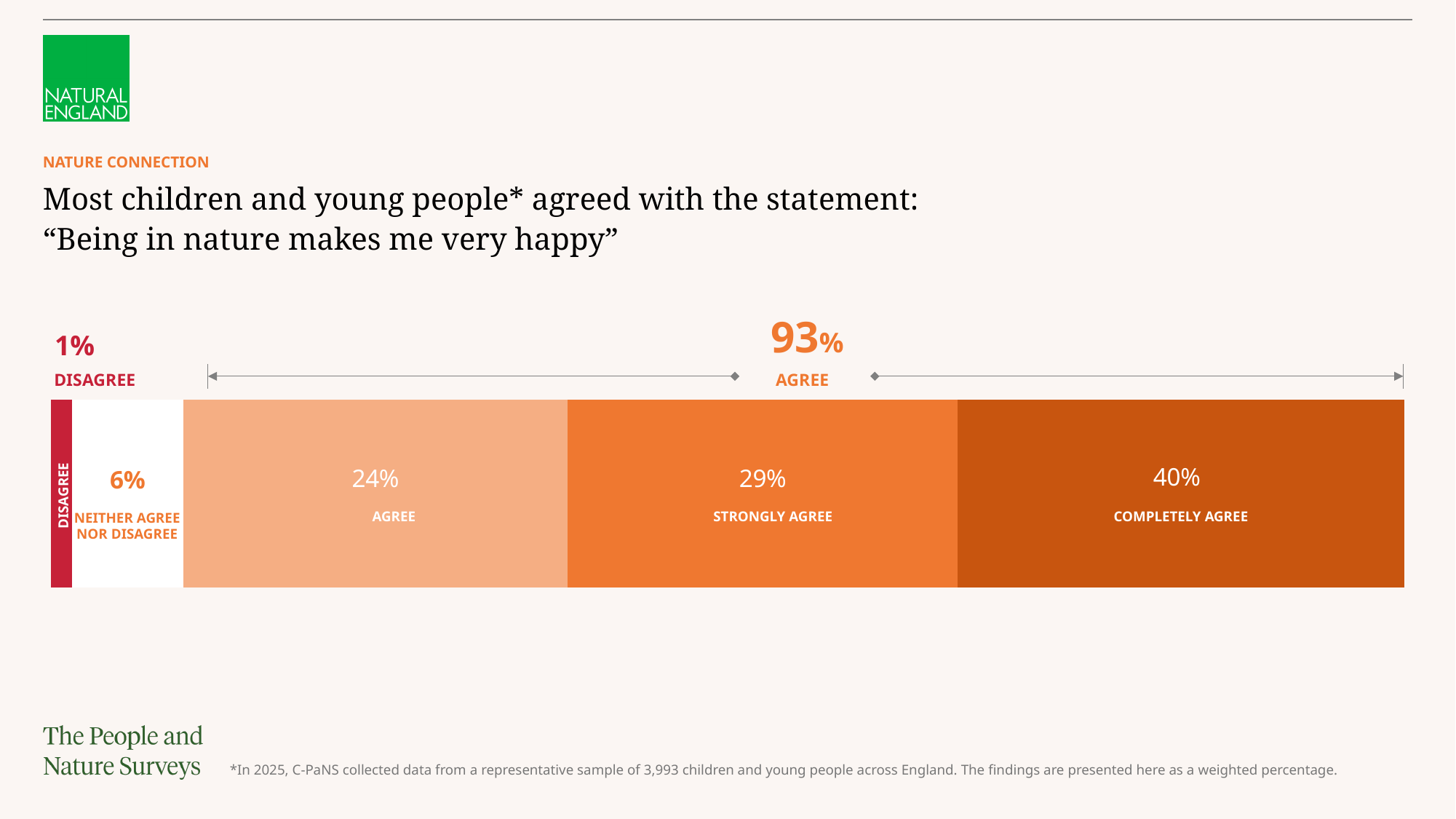
What percentage of respondents neither agree nor disagree? 6% What percentage of respondents disagree with the statement? 1% How many response categories are shown in the bar? 5 What is the difference between the completely agree and agree percentages? 16% What is the combined percentage shown for all respondents who agree? 93% Which is larger, the strongly agree share or the agree share? Strongly agree What is the total of the agree, strongly agree and completely agree segments? 93% What percentage of children and young people said they completely agree with the statement? 40% What percentage of respondents strongly agree with the statement? 29% What kind of chart is shown on the slide? Stacked bar chart Which response category has the largest share? Completely agree Which response category has the smallest share? Disagree